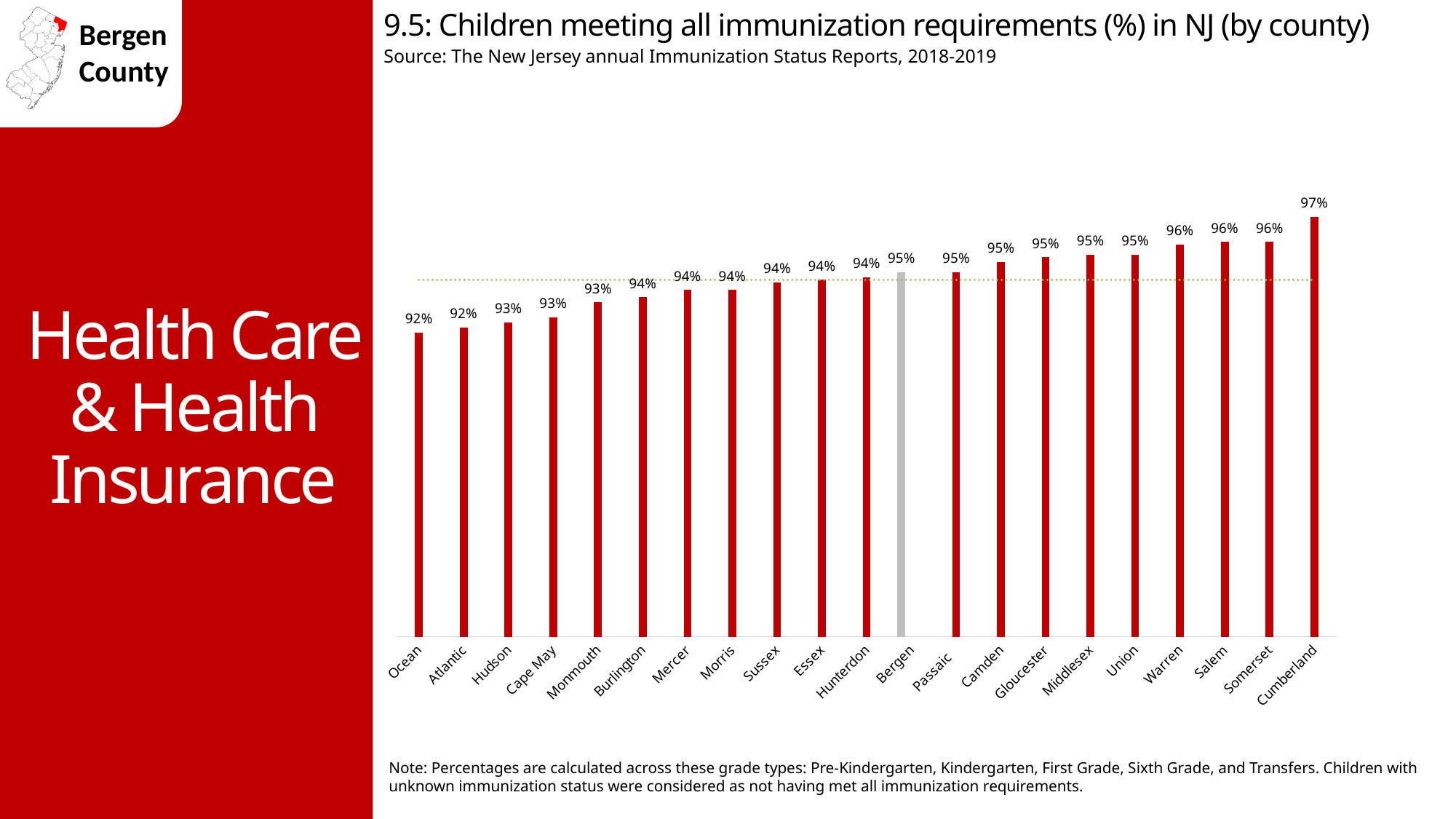
What kind of chart is shown on the slide? Bar chart Which county has the highest percentage of children meeting all immunization requirements? Cumberland What is the difference in percentage points between Cumberland and Ocean? 5 percentage points What percentage of children in Bergen County met all immunization requirements? 95% What is the difference in percentage points between Bergen and Ocean? 3 percentage points What percentage is shown for Monmouth? 93% Which has a higher value, Bergen or Hudson? Bergen Which county's bar is coloured grey instead of red? Bergen What is the value shown for Cumberland? 97% How many counties are shown in the chart? 21 What is the value shown for Ocean County? 92% Do the values rise or fall moving from left to right along the x axis? Rise